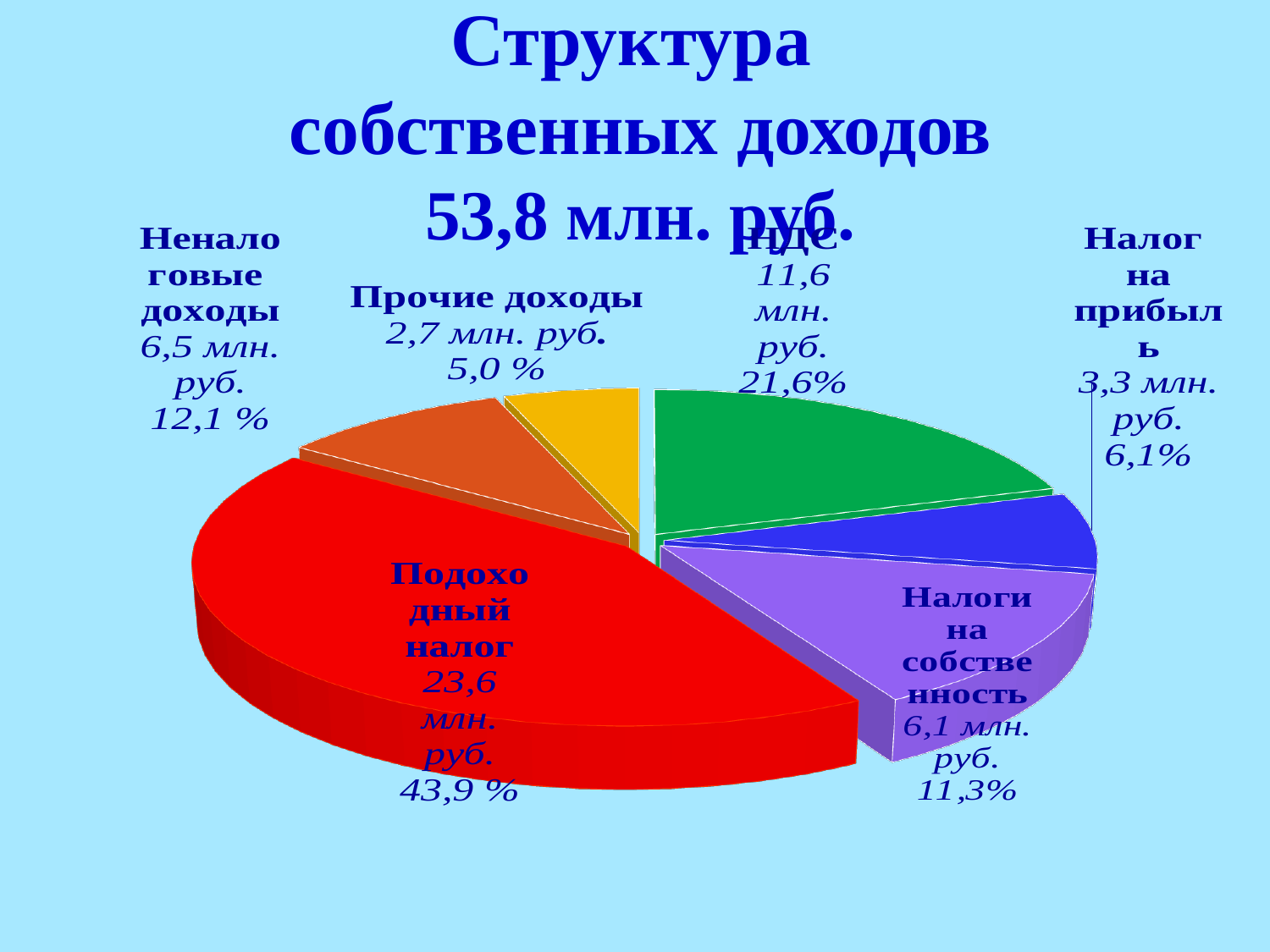
What is the value for Неналоговые доходы in млн. руб.? 6,5 млн. руб. Which is larger, НДС or Неналоговые доходы? НДС What share of the pie does НДС represent? 21,6% What is the value for Налог на прибыль in млн. руб.? 3,3 млн. руб. What kind of chart is shown on the slide? Pie chart What percentage share is shown for Налоги на собственность? 11,3% Which category has the largest slice of the pie? Подоходный налог Which category has the smallest slice of the pie? Прочие доходы How many slices does the pie chart have? 6 What percentage share is shown for Прочие доходы? 5,0 % What is the value for Подоходный налог in млн. руб.? 23,6 млн. руб. What total amount of own revenues is stated in the chart title? 53,8 млн. руб.